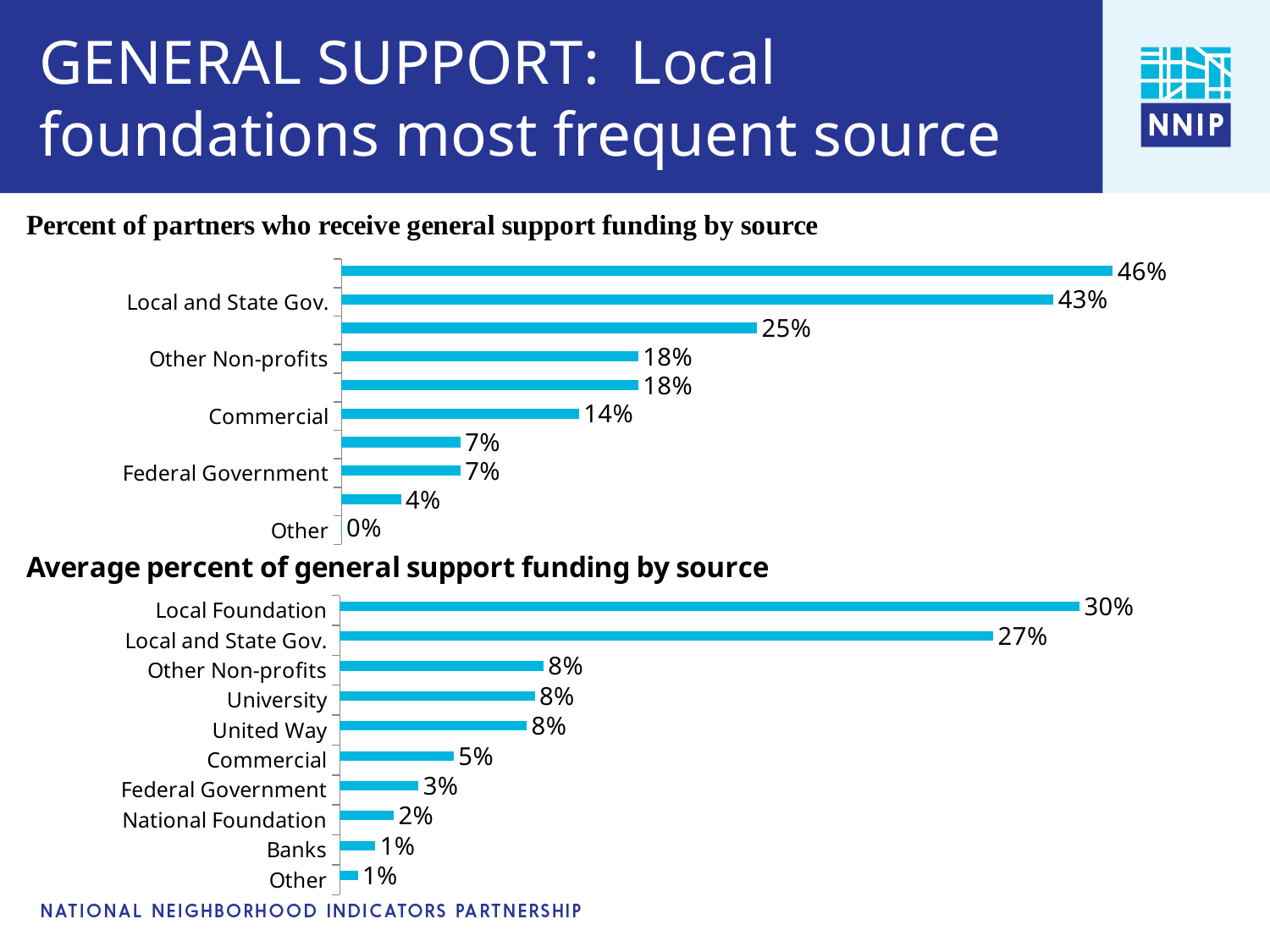
In the 'Average percent of general support funding by source' chart, what is the value for Local Foundation? 30% In the 'Average percent of general support funding by source' chart, which source has the highest value? Local Foundation In the 'Average percent of general support funding by source' chart, what is the value for Banks? 1% How many sources are shown in the 'Average percent of general support funding by source' chart? 10 In the 'Percent of partners who receive general support funding by source' chart, which is larger: Other Non-profits or Commercial? Other Non-profits In the 'Percent of partners who receive general support funding by source' chart, what is the value for Commercial? 14% In the 'Average percent of general support funding by source' chart, what is the difference between Local Foundation and Local and State Gov.? 3% In the 'Percent of partners who receive general support funding by source' chart, what is the difference between Local and State Gov. and Federal Government? 36% In the 'Percent of partners who receive general support funding by source' chart, what is the value for Local and State Gov.? 43% What kind of chart is the 'Average percent of general support funding by source' chart? Bar chart In the 'Percent of partners who receive general support funding by source' chart, which labeled source has the lowest value? Other In the 'Average percent of general support funding by source' chart, what is the value for Commercial? 5%